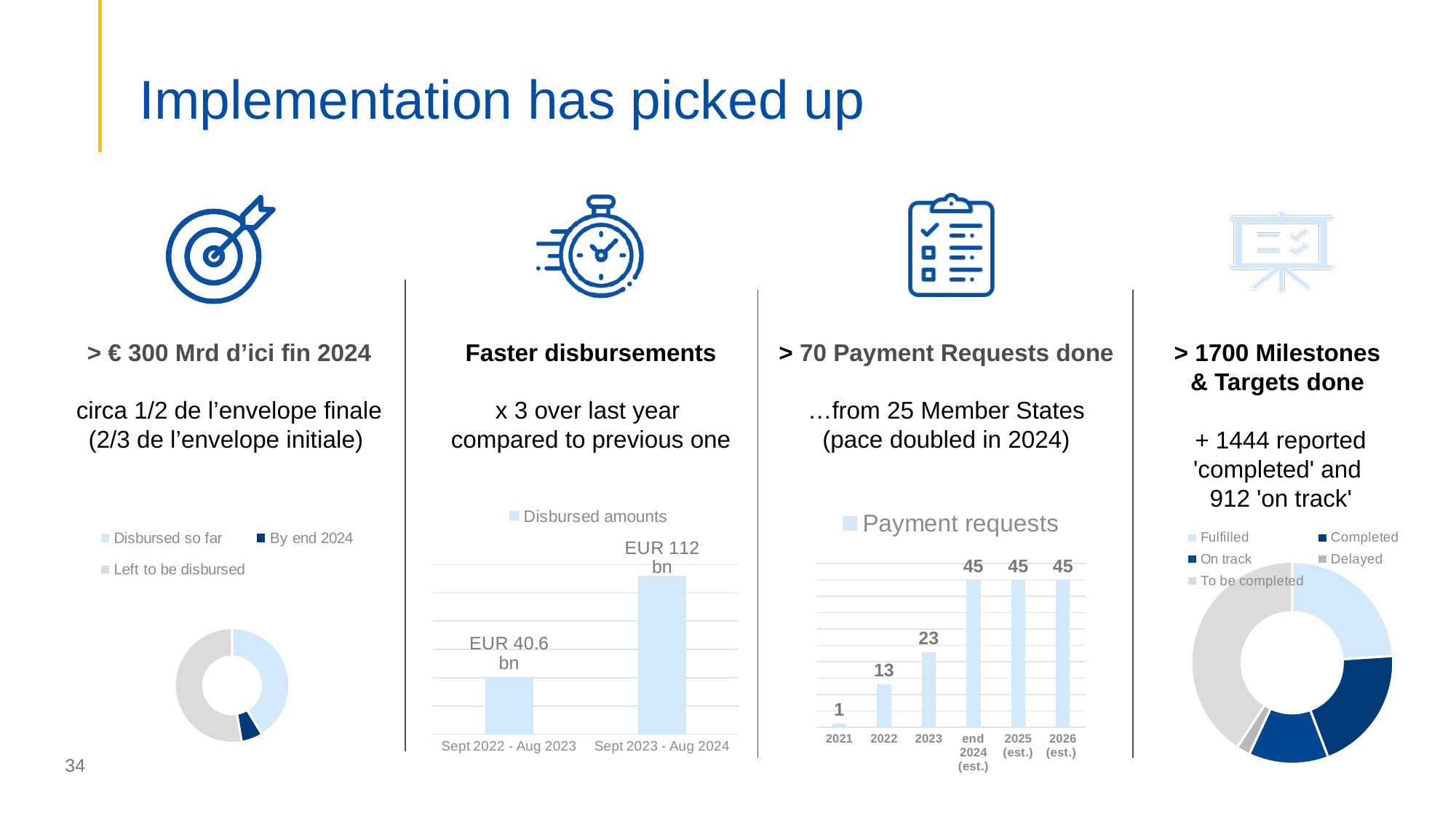
In the 'Disbursed amounts' chart, what is the value for Sept 2022 - Aug 2023? EUR 40.6 bn How many entries does the legend of the rightmost donut chart list? 5 In the 'Payment requests' chart, what is the value for 2023? 23 In the 'Disbursed amounts' chart, what is the value for Sept 2023 - Aug 2024? EUR 112 bn In the 'Payment requests' chart, which year has the lowest value? 2021 In the 'Payment requests' chart, do the values rise or fall from 2021 to end 2024 (est.)? rise What kind of chart is the 'Payment requests' chart? bar chart In the 'Disbursed amounts' chart, which period has the higher value? Sept 2023 - Aug 2024 In the 'Payment requests' chart, how many categories are shown on the x axis? 6 In the 'Payment requests' chart, what is the value for 2021? 1 In the 'Payment requests' chart, what is the difference between the values for 2023 and 2022? 10 In the 'Disbursed amounts' chart, how many bars are plotted? 2